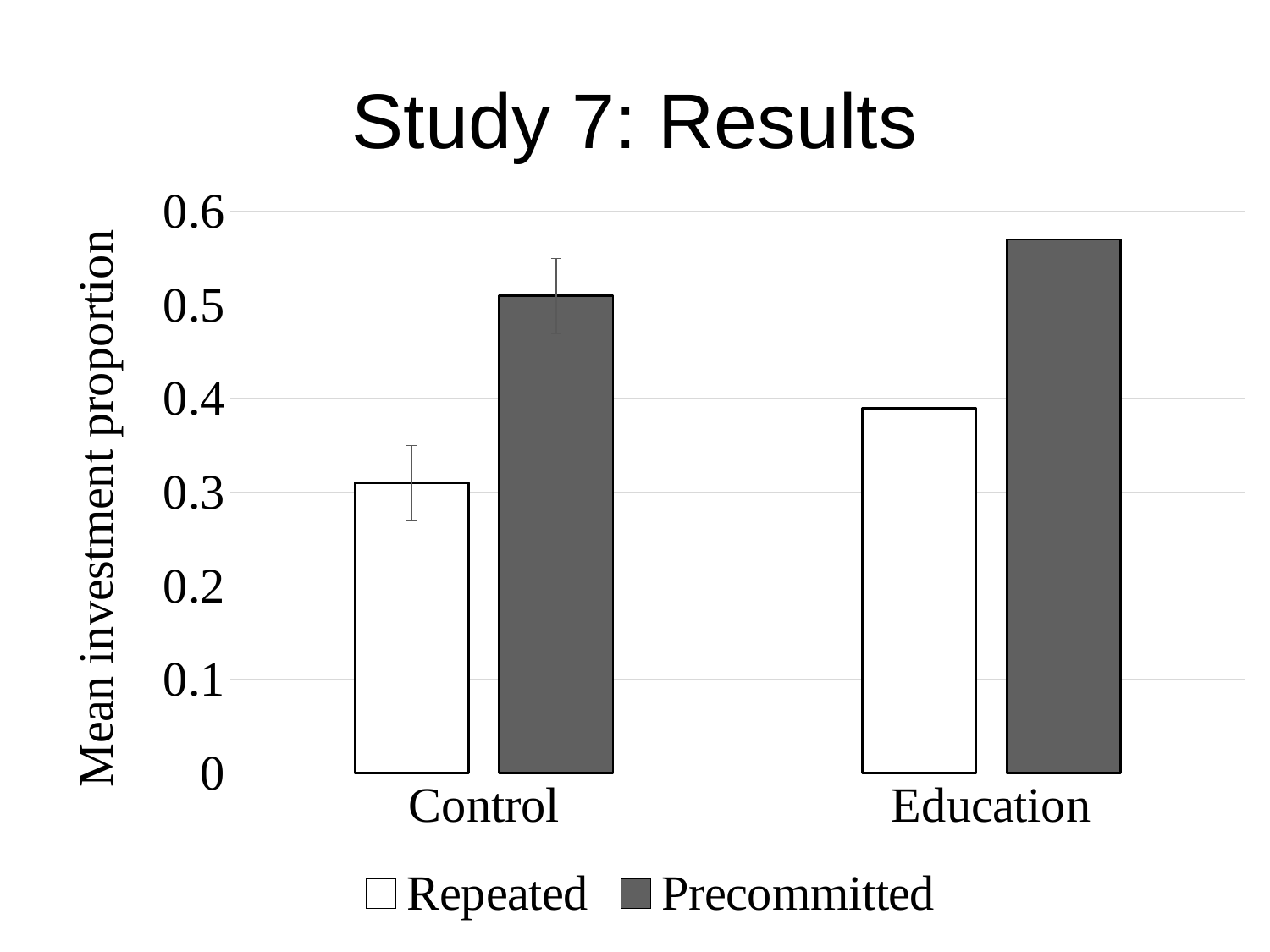
Is the value for Precommitted in the Education condition greater or less than 0.5? greater In the Education condition, which is larger: Repeated or Precommitted? Precommitted How many series does the legend list? 2 Is the value for Repeated in the Control condition greater or less than 0.4? less What is the label of the y axis? Mean investment proportion For the Repeated series, which condition has the larger value: Control or Education? Education Which bar is the lowest in the chart? Repeated (Control) Which series has the highest bar in the chart? Precommitted (Education) What kind of chart is shown on the slide? bar chart How many categories are shown on the x axis? 2